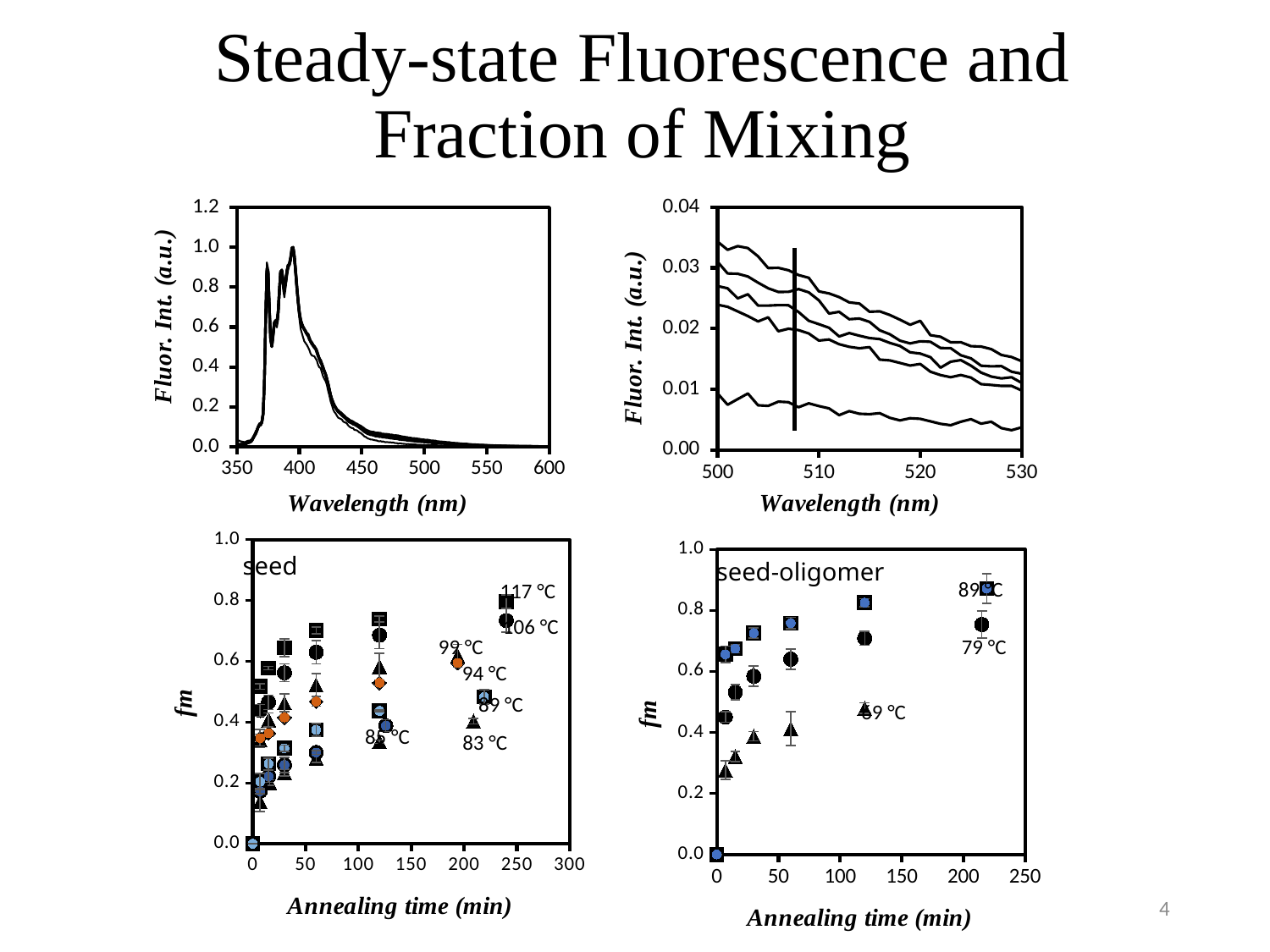
In the bottom-right 'seed-oligomer' chart, how many temperature series are labelled? 3 What is the x-axis label of the bottom-right 'seed-oligomer' chart? Annealing time (min) What kind of chart is the top-left chart (Fluor. Int. vs Wavelength, 350-600 nm)? line chart In the bottom-right 'seed-oligomer' chart, which has the higher fm at the last annealing time, the 89 °C series or the 79 °C series? 89 °C In the top-left chart, is the peak fluorescence intensity greater or less than 0.8? greater In the top-right chart (500-530 nm), do the fluorescence intensity values rise or fall as wavelength increases? fall In the bottom-left 'seed' chart, which labelled temperature series reaches the highest fm value? 117 °C In the top-right chart, is the value of the lowest line at 530 nm greater or less than 0.01? less In the top-right chart, is the value of the highest line at 500 nm greater or less than 0.03? greater In the bottom-left 'seed' chart, how many temperature series are labelled? 7